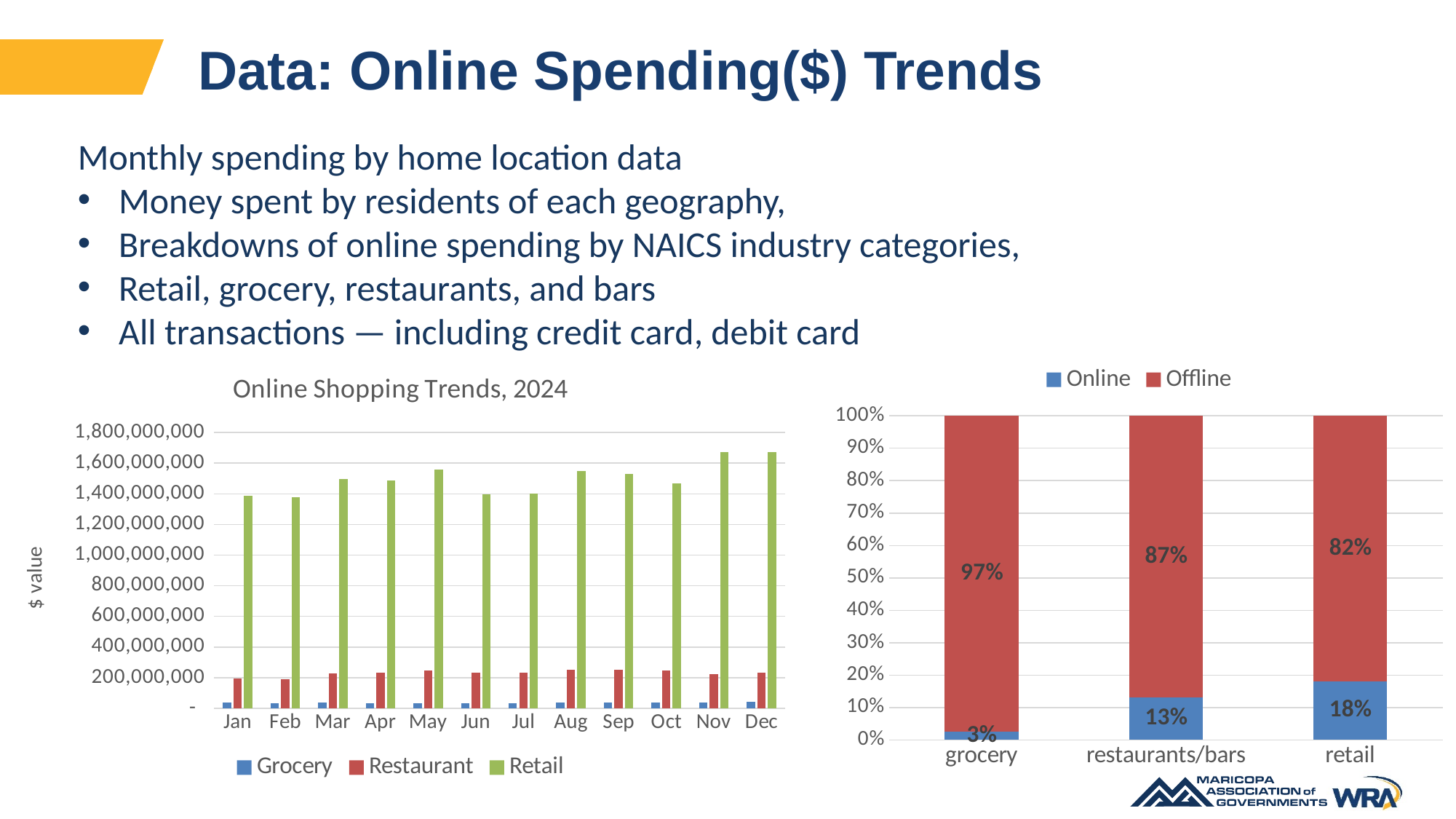
In the stacked bar chart on the right, which two series does the legend list? Online and Offline In the stacked bar chart on the right, what is the difference between the Offline and Online shares for restaurants/bars? 74 percentage points What kind of chart is the 'Online Shopping Trends, 2024' chart on the left? bar chart In the stacked bar chart on the right, what is the Offline share for grocery? 97% In the 'Online Shopping Trends, 2024' chart, which is larger in Jun: Grocery or Restaurant? Restaurant In the 'Online Shopping Trends, 2024' chart, how many series does the legend list? 3 In the 'Online Shopping Trends, 2024' chart, which series has the highest values in every month? Retail In the 'Online Shopping Trends, 2024' chart, is the Restaurant value for Aug greater or less than 400,000,000? less In the 'Online Shopping Trends, 2024' chart, how many months are shown on the x axis? 12 In the 'Online Shopping Trends, 2024' chart, is the Retail value for Nov greater or less than 1,600,000,000? greater In the stacked bar chart on the right, which category has the lowest Online share? grocery In the stacked bar chart on the right, what is the Online share for retail? 18%